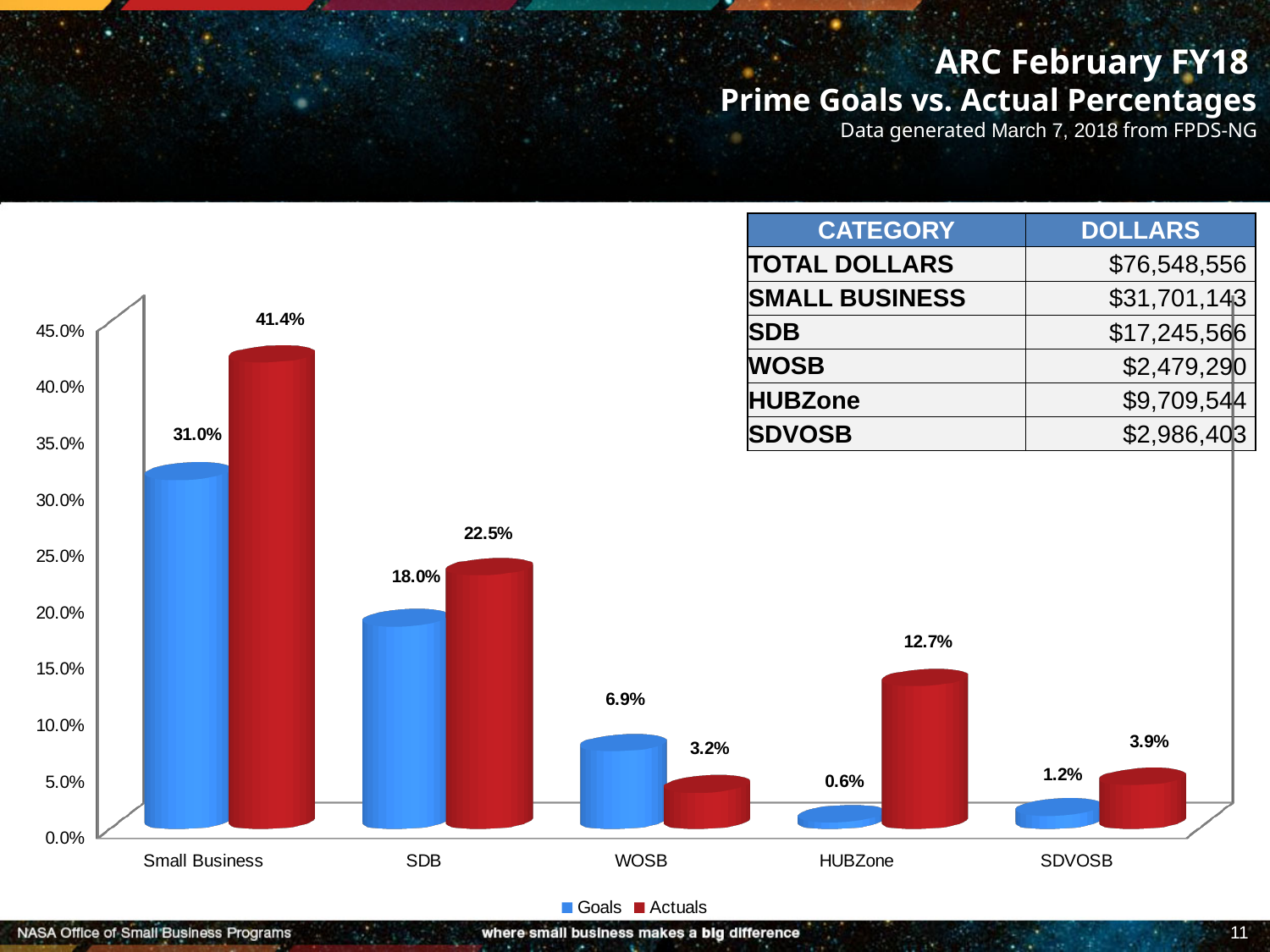
Which is larger for HUBZone, the Goals value or the Actuals value? Actuals What is the difference between the Actuals and Goals values for Small Business? 10.4% What is the Actuals value for SDVOSB? 3.9% How many categories are shown on the x axis of the chart? 5 What is the difference between the Goals and Actuals values for WOSB? 3.7% What kind of chart is shown on the slide? Bar chart What is the Goals value for HUBZone? 0.6% What is the Goals value for SDB? 18.0% Which category has the highest Actuals value? Small Business How many series does the chart legend list? 2 Which category has the lowest Goals value? HUBZone What is the Actuals value for Small Business? 41.4%